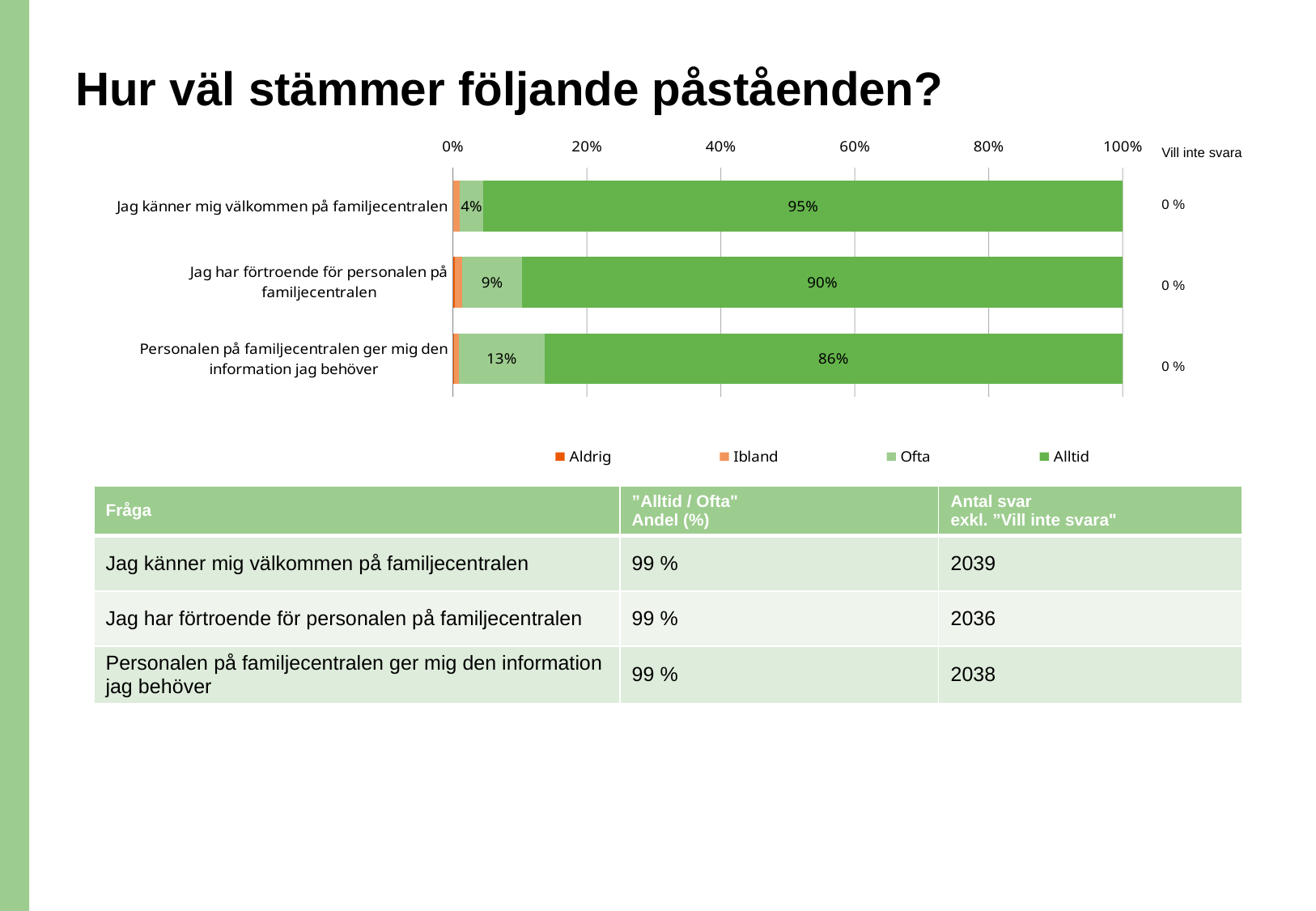
Which statement has the lowest "Ofta" value? Jag känner mig välkommen på familjecentralen What is the "Alltid" value for "Jag känner mig välkommen på familjecentralen"? 95% What is the "Alltid" value for "Jag har förtroende för personalen på familjecentralen"? 90% How many statements (categories) are plotted in the chart? 3 What is the "Ofta" value for "Personalen på familjecentralen ger mig den information jag behöver"? 13% What is the difference between the "Alltid" values for "Jag känner mig välkommen på familjecentralen" and "Personalen på familjecentralen ger mig den information jag behöver"? 9% What is the "Ofta" value for "Jag har förtroende för personalen på familjecentralen"? 9% Is the "Alltid" value for "Personalen på familjecentralen ger mig den information jag behöver" greater or less than 80%? greater What kind of chart is shown on the slide? bar chart Which statement has the highest "Alltid" value? Jag känner mig välkommen på familjecentralen Which legend entry is shown in the darkest green colour? Alltid How many series does the chart legend list? 4